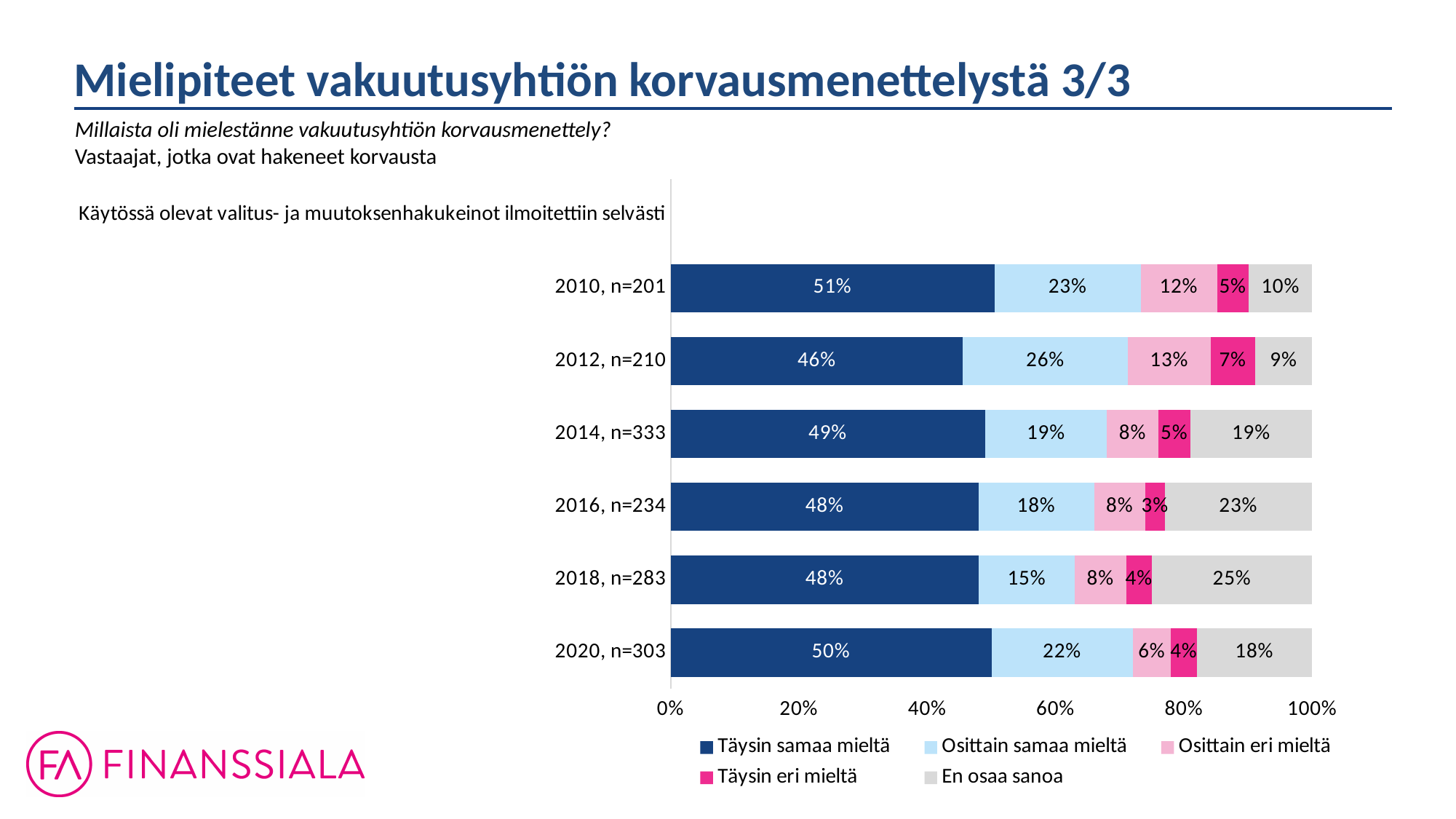
What is the total of the stacked bar for 2014, n=333? 100% Which year has the highest value for 'Täysin samaa mieltä'? 2010, n=201 How many year categories are shown in the chart? 6 Which is larger: 'En osaa sanoa' in 2014, n=333 or in 2020, n=303? 2014, n=333 What is the value for 'Osittain samaa mieltä' in 2020, n=303? 22% Which year has the lowest value for 'Täysin eri mieltä'? 2016, n=234 Which year has the lowest value for 'Täysin samaa mieltä'? 2012, n=210 What is the difference between the 'Osittain samaa mieltä' values for 2012, n=210 and 2018, n=283? 11 percentage points What is the value for 'En osaa sanoa' in 2018, n=283? 25% What is the value for 'Täysin samaa mieltä' in 2010, n=201? 51% What type of chart is shown on the slide? Stacked bar chart How many series does the legend list? 5